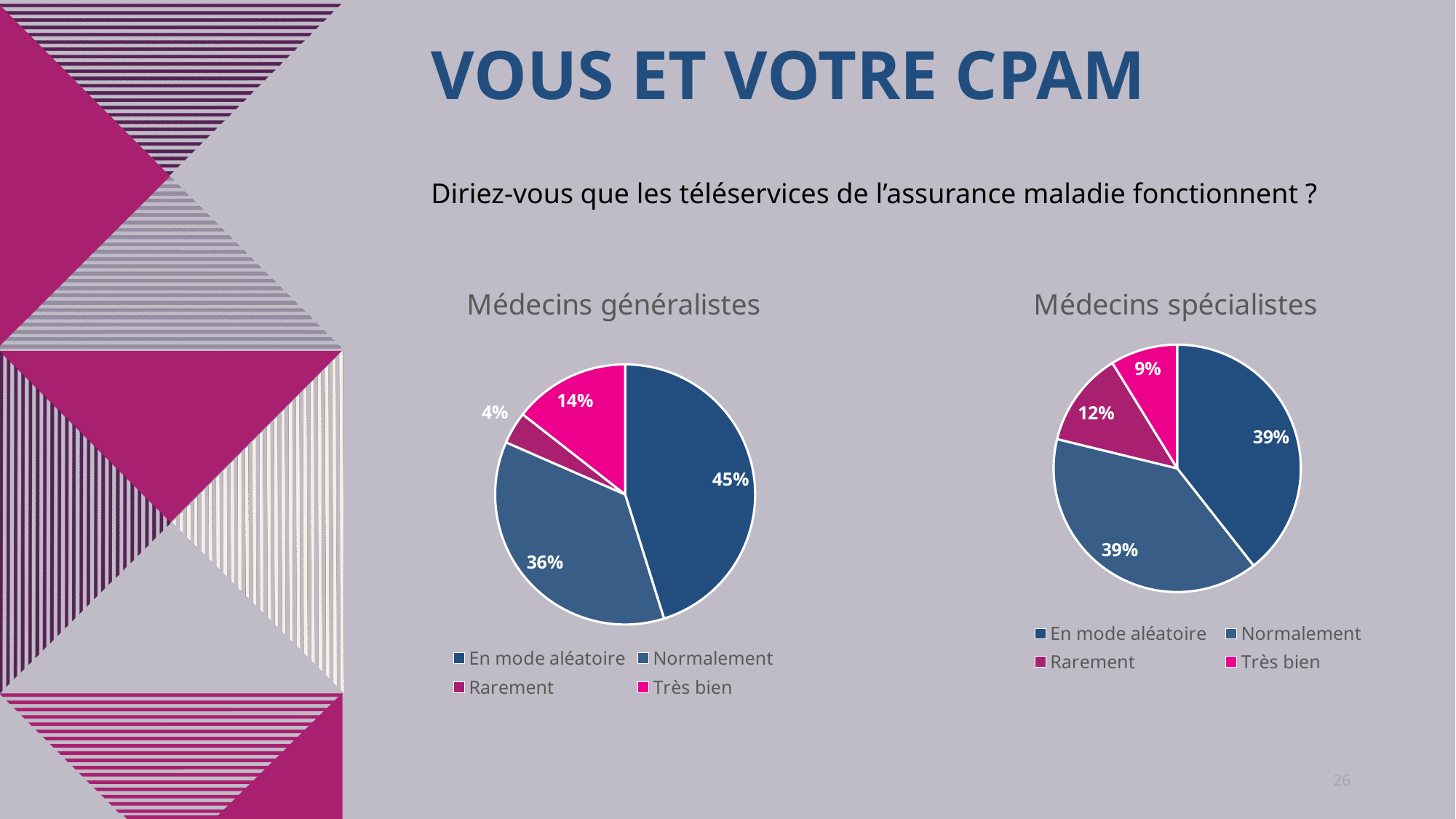
In the 'Médecins spécialistes' chart, what share is labelled for 'Rarement'? 12% In the 'Médecins spécialistes' chart, which category has the smallest slice? Très bien In the 'Médecins généralistes' chart, which category has the largest slice? En mode aléatoire In the 'Médecins généralistes' chart, what share is labelled for 'En mode aléatoire'? 45% In the 'Médecins spécialistes' chart, what colour is the 'Très bien' slice? Pink In the 'Médecins généralistes' chart, what is the difference between the 'En mode aléatoire' and 'Normalement' shares? 9% What type of chart is used for 'Médecins spécialistes'? Pie chart In the 'Médecins spécialistes' chart, what share is labelled for 'Très bien'? 9% Which is larger in the 'Médecins généralistes' chart: the 'Très bien' slice or the 'Rarement' slice? Très bien How many categories does the legend of the 'Médecins spécialistes' chart list? 4 In the 'Médecins généralistes' chart, which category has the smallest slice? Rarement In the 'Médecins généralistes' chart, what share is labelled for 'Rarement'? 4%